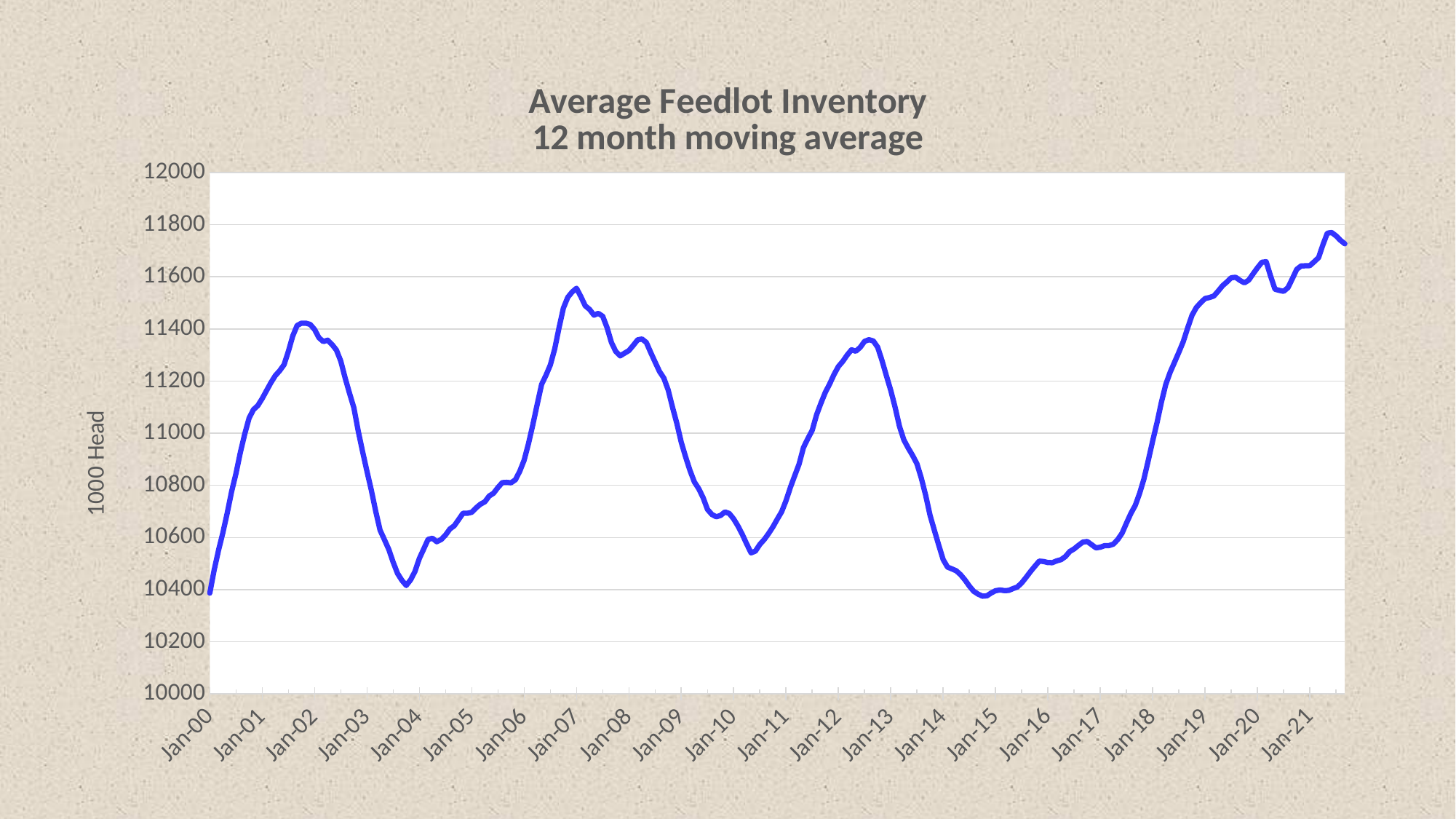
Is the value at Jan-07 greater or less than 11200? greater What kind of chart is shown on the slide? line chart Does the line rise or fall between Jan-13 and Jan-15? fall Is the value at Jan-04 greater or less than 10600? less What is the title of the chart? Average Feedlot Inventory 12 month moving average Is the value at Jan-02 greater or less than 11200? greater How many year labels are shown on the horizontal axis? 22 Does the line rise or fall between Jan-17 and Jan-19? rise What is the label on the vertical axis? 1000 Head